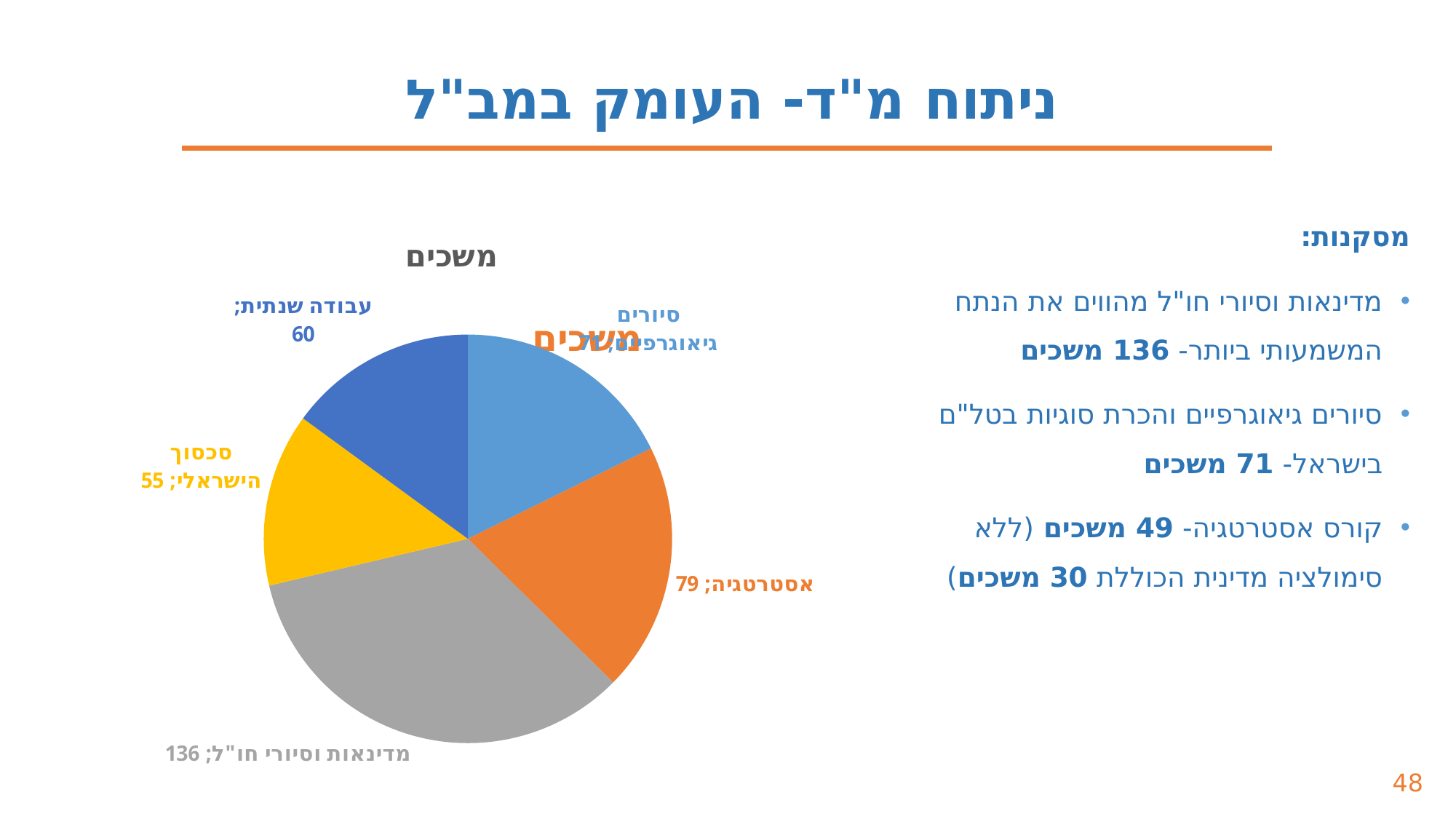
What is the value for אסטרטגיה? 79 Which slice of the pie chart is the smallest? סכסוך הישראלי What is the value for עבודה שנתית? 60 Which slice of the pie chart is the largest? מדינאות וסיורי חו"ל What is the difference between the values for מדינאות וסיורי חו"ל and אסטרטגיה? 57 What is the value for סכסוך הישראלי? 55 What is the value for מדינאות וסיורי חו"ל? 136 Which is larger, אסטרטגיה or עבודה שנתית? אסטרטגיה How many slices does the pie chart have? 5 What kind of chart is shown on the slide? pie chart What is the difference between the values for עבודה שנתית and סכסוך הישראלי? 5 What is the chart's title? משכים